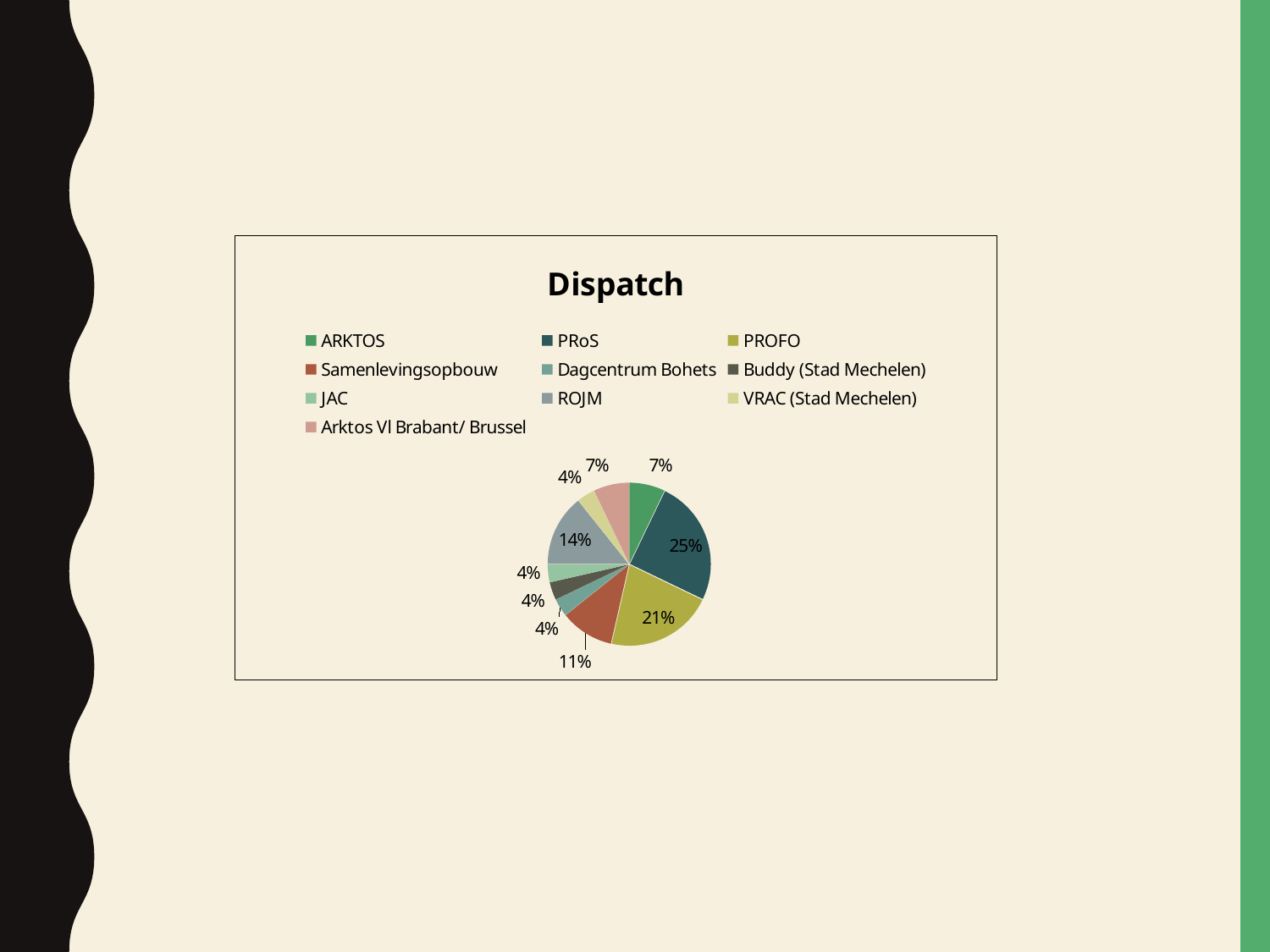
What share of the Dispatch pie does PROFO have? 21% What share of the Dispatch pie does ARKTOS have? 7% What share of the Dispatch pie does ROJM have? 14% How many categories does the legend of the Dispatch chart list? 10 Which category has the largest share of the Dispatch pie? PRoS What is the title of the chart? Dispatch What is the difference in percentage points between the PRoS share and the PROFO share? 4 What type of chart is shown on the slide? pie chart Which has a larger share of the Dispatch pie, ROJM or Samenlevingsopbouw? ROJM